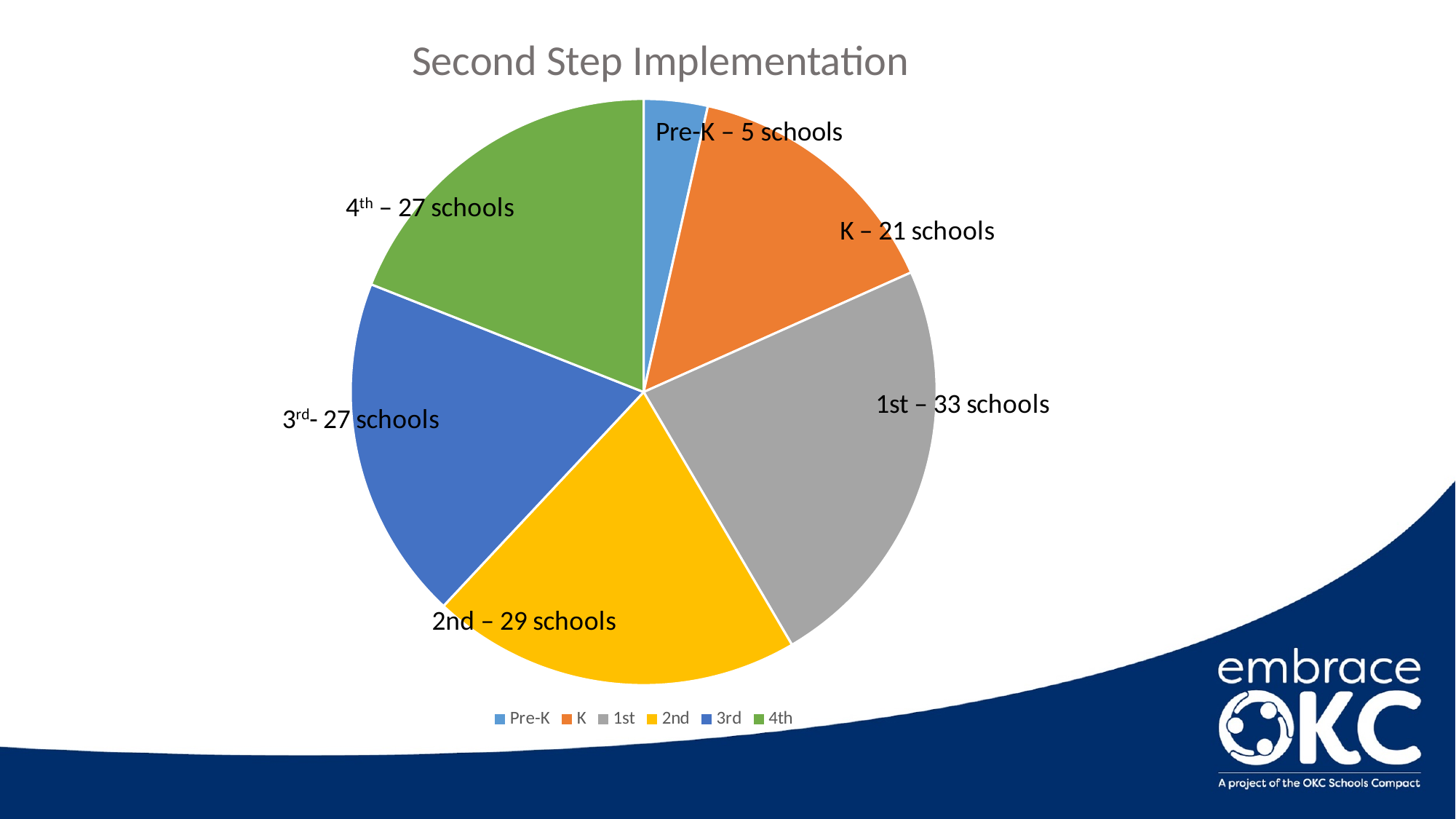
How many schools are shown for 2nd grade? 29 schools How many slices does the pie chart have? 6 What is the total number of schools across all slices of the pie? 142 schools Which has more schools, 2nd grade or K? 2nd What is the title of the chart? Second Step Implementation Which grade has the smallest slice of the pie? Pre-K What is the difference in the number of schools between 1st grade and K? 12 schools Which grade has the largest slice of the pie? 1st How many schools are shown for 1st grade? 33 schools How many schools are shown for Pre-K? 5 schools How many schools are shown for K? 21 schools What kind of chart is shown on the slide? pie chart